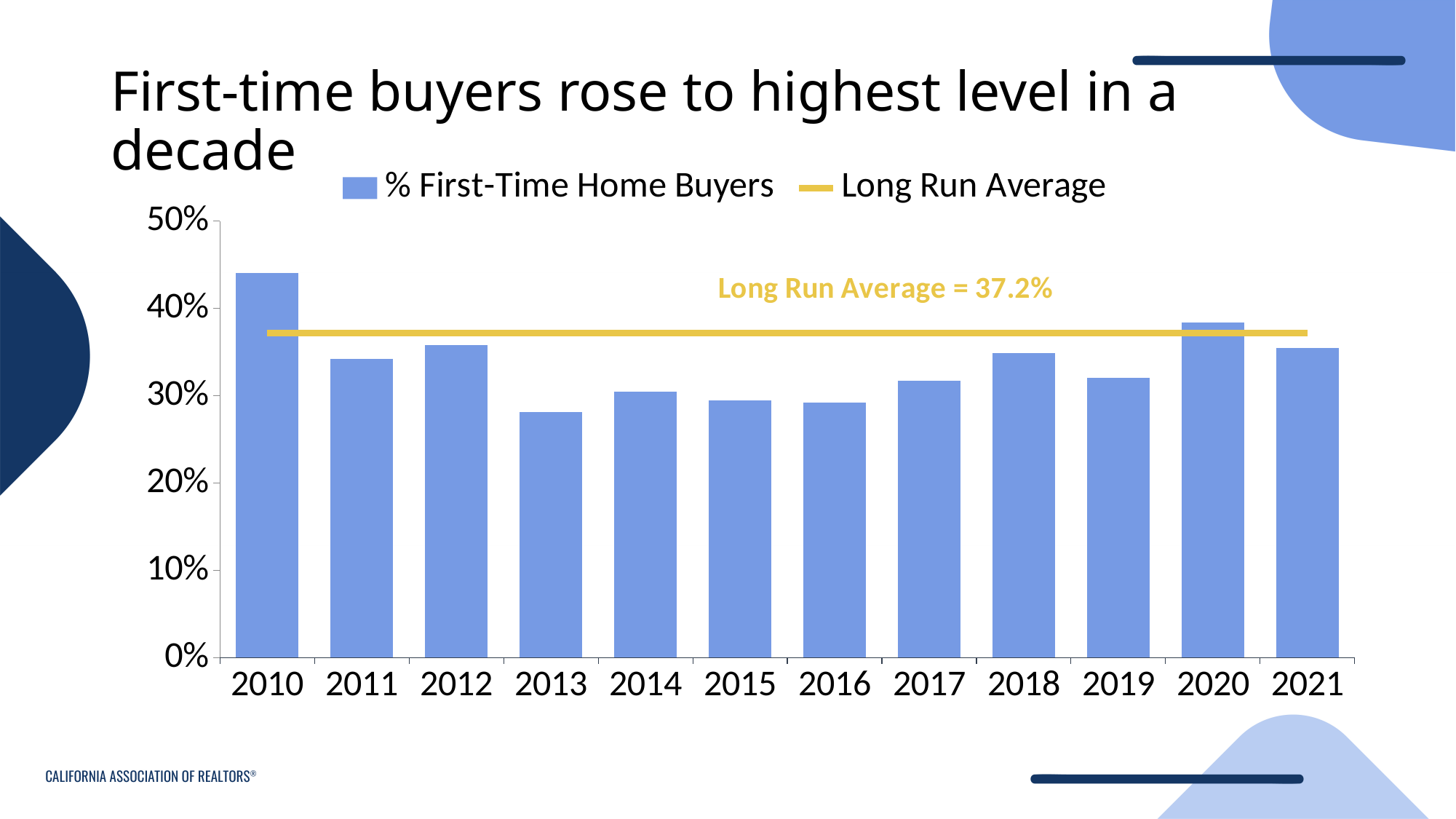
Is the value for 2013 greater or less than 30%? less Is the value for 2010 greater or less than 40%? greater Which year has a higher share of first-time home buyers, 2010 or 2020? 2010 What is the long run average shown on the chart? 37.2% Is the value for 2020 greater or less than 40%? less Which year has the lowest share of first-time home buyers? 2013 Which year has a higher share of first-time home buyers, 2013 or 2018? 2018 How many years are shown on the x axis of the chart? 12 What is the title of the slide? First-time buyers rose to highest level in a decade Which year has the highest share of first-time home buyers? 2010 What kind of chart is shown on the slide? bar chart How many series does the chart legend list? 2